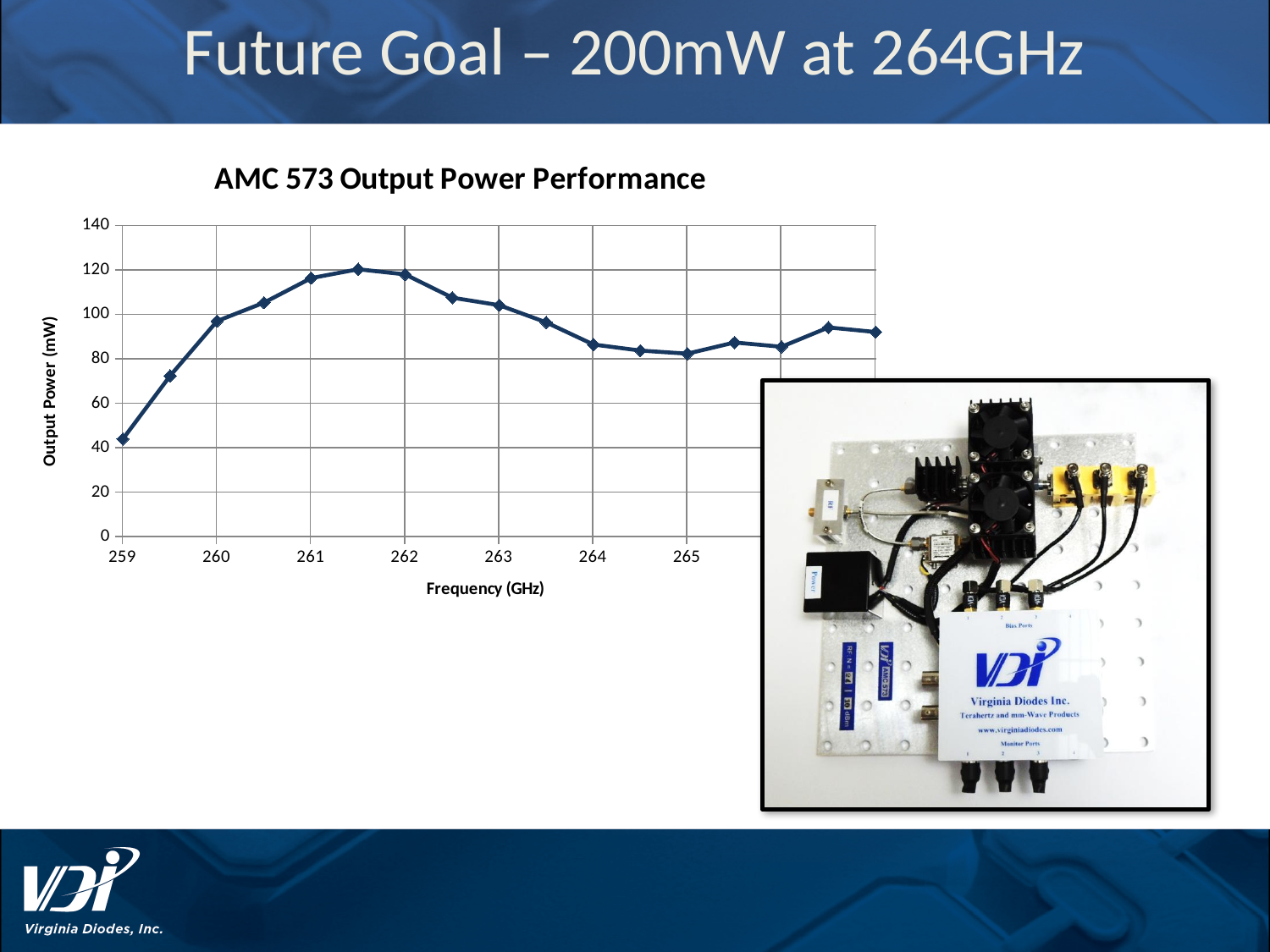
At which frequency is the output power lowest? 259 GHz Does the output power rise or fall as frequency increases from 262 GHz to 265 GHz? fall Which frequency has the higher output power, 261 GHz or 264 GHz? 261 GHz What kind of chart is shown on the slide? line chart What is the title of the chart? AMC 573 Output Power Performance Is the output power at 259 GHz greater or less than 60 mW? less What is the label of the vertical axis of the chart? Output Power (mW) Which frequency has the higher output power, 259 GHz or 265 GHz? 265 GHz Is the output power at 264 GHz greater or less than 100 mW? less Is the output power at 262 GHz greater or less than 100 mW? greater